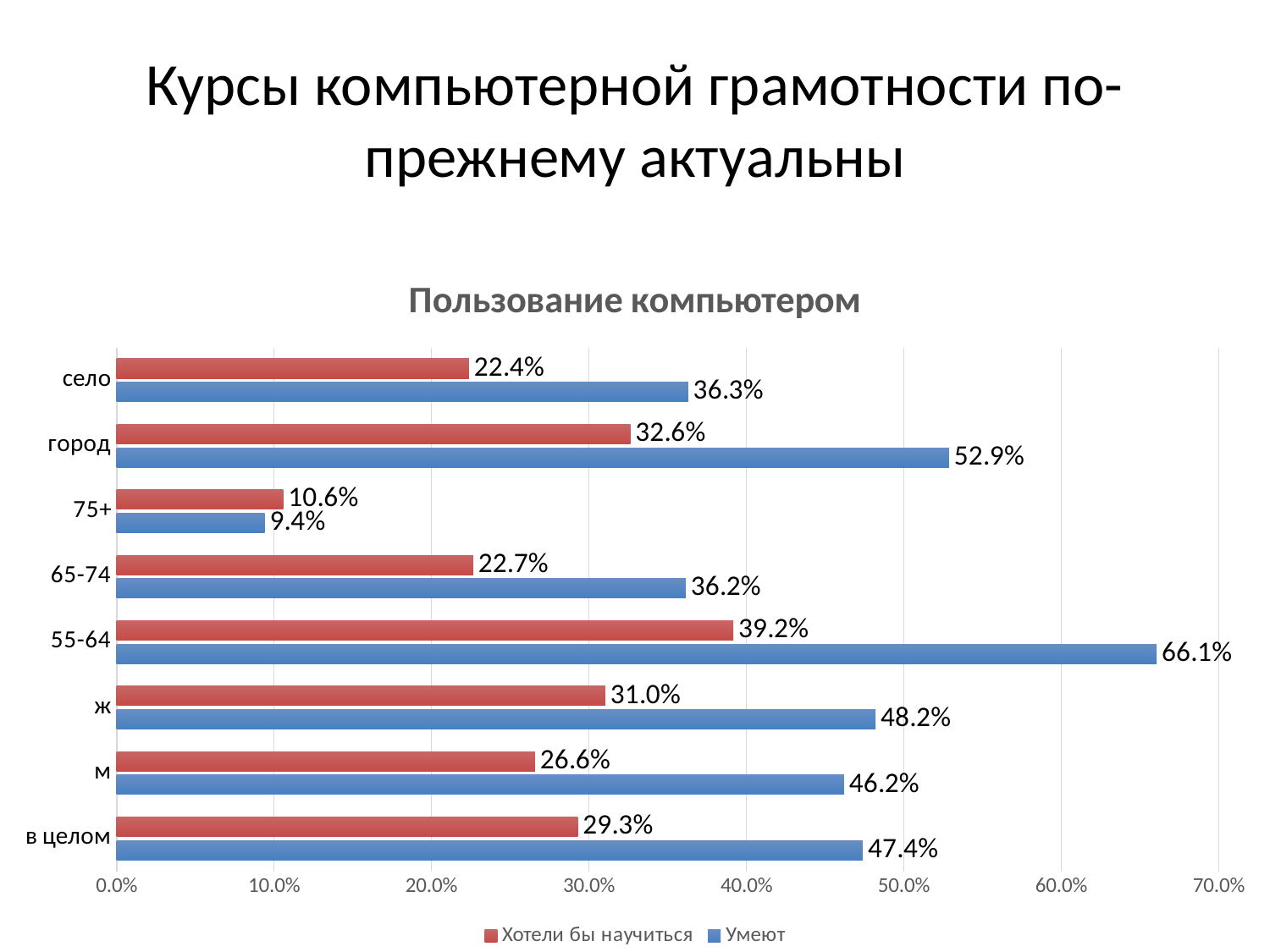
How many series does the legend list? 2 How many categories are shown on the chart? 8 Which category has the lowest value for "Хотели бы научиться"? 75+ What is the value of "Хотели бы научиться" for the category "55-64"? 39.2% What type of chart is shown on the slide? bar chart Which category has the highest value for "Умеют"? 55-64 What is the difference between "Умеют" and "Хотели бы научиться" for the category "в целом"? 18.1% Is the value of "Умеют" for "ж" greater or less than 40.0%? greater What is the value of "Умеют" for the category "город"? 52.9% For the category "75+", which is larger: "Хотели бы научиться" or "Умеют"? Хотели бы научиться What is the value of "Умеют" for the category "село"? 36.3% What is the title of the chart? Пользование компьютером